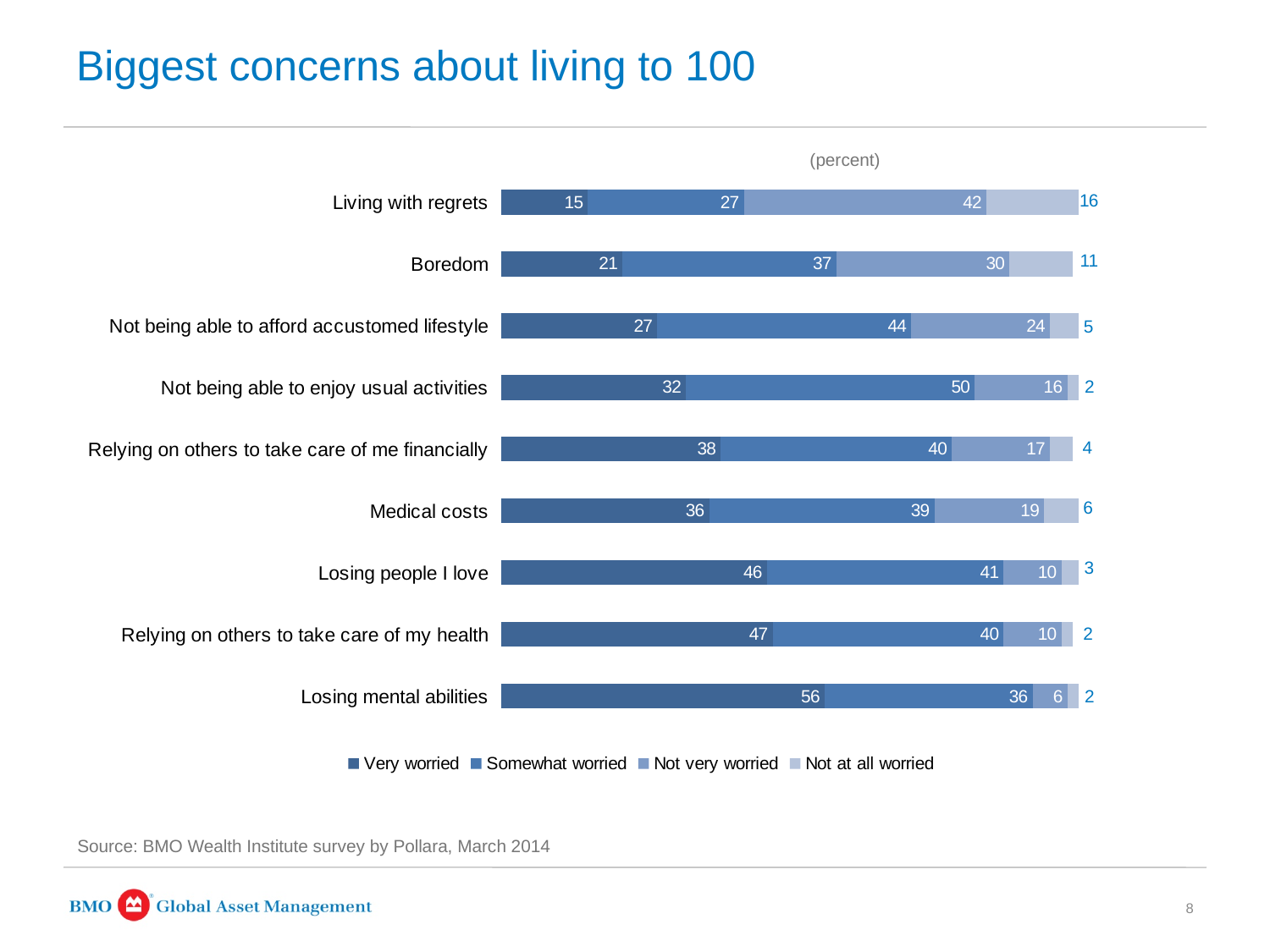
Which has a larger 'Very worried' value: 'Medical costs' or 'Relying on others to take care of me financially'? Relying on others to take care of me financially How many series does the legend list? 4 What kind of chart is shown on the slide? Stacked bar chart What is the 'Not at all worried' value for 'Living with regrets'? 16 Which concern has the lowest 'Very worried' value? Living with regrets How many concerns are listed in the chart? 9 What is the total of the four segments for 'Boredom'? 99 What is the 'Not very worried' value for 'Not being able to enjoy usual activities'? 16 Which concern has the highest 'Very worried' value? Losing mental abilities What percentage of respondents are very worried about losing mental abilities? 56 What is the difference between the 'Somewhat worried' values for 'Boredom' and 'Living with regrets'? 10 Which concern has the highest 'Not very worried' value? Living with regrets